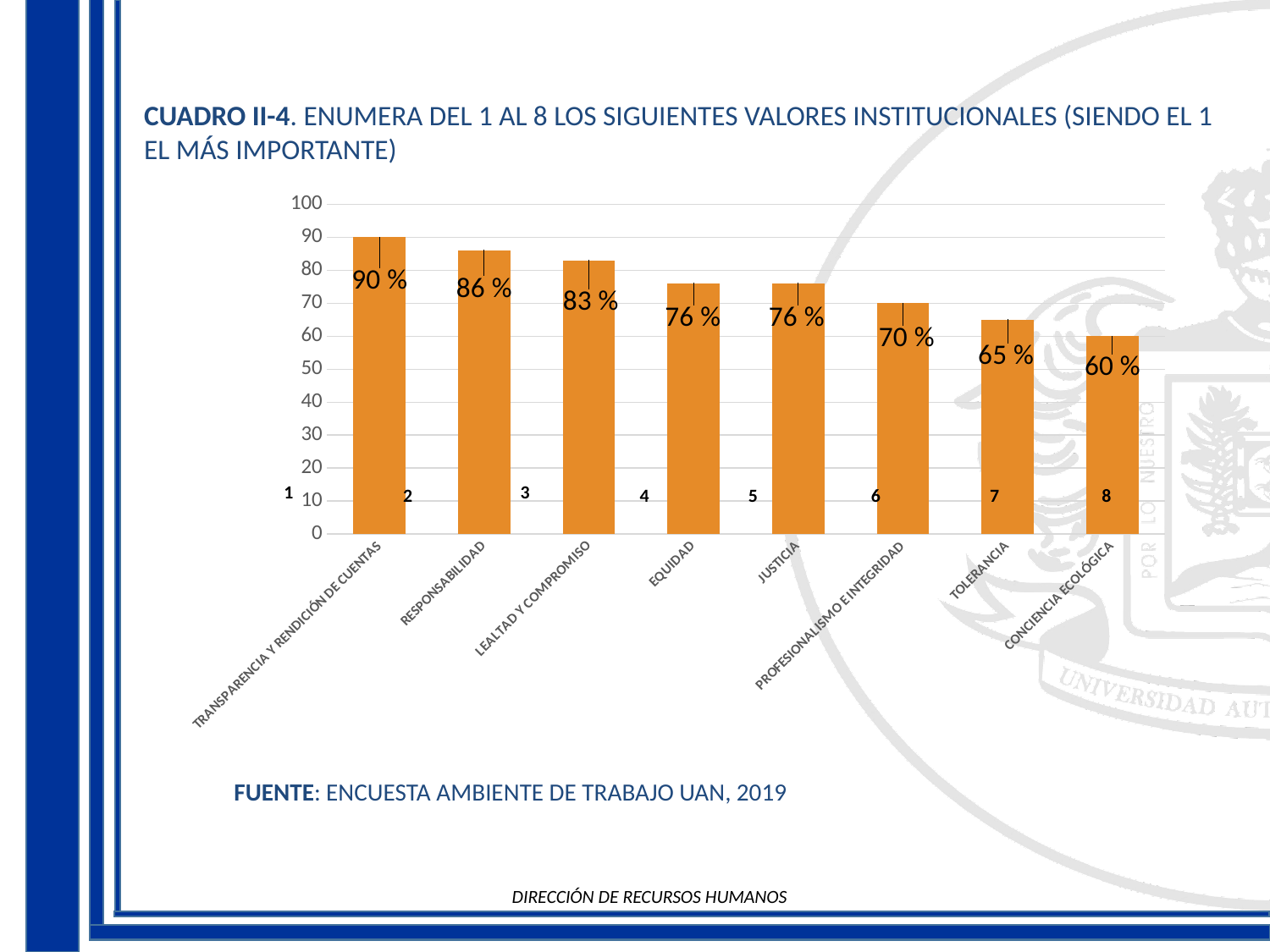
What is the difference between the values for RESPONSABILIDAD and PROFESIONALISMO E INTEGRIDAD? 16 % What is the value for LEALTAD Y COMPROMISO? 83 % Is the value for JUSTICIA greater or less than 70? greater What source is cited below the chart? ENCUESTA AMBIENTE DE TRABAJO UAN, 2019 What is the value for TOLERANCIA? 65 % Do the values rise or fall from left to right along the x axis? Fall What is the value for TRANSPARENCIA Y RENDICIÓN DE CUENTAS? 90 % Which category has the highest value? TRANSPARENCIA Y RENDICIÓN DE CUENTAS What kind of chart is shown on the slide? Bar chart Which is larger, the value for EQUIDAD or the value for TOLERANCIA? EQUIDAD Which category has the lowest value? CONCIENCIA ECOLÓGICA How many categories are shown on the chart? 8